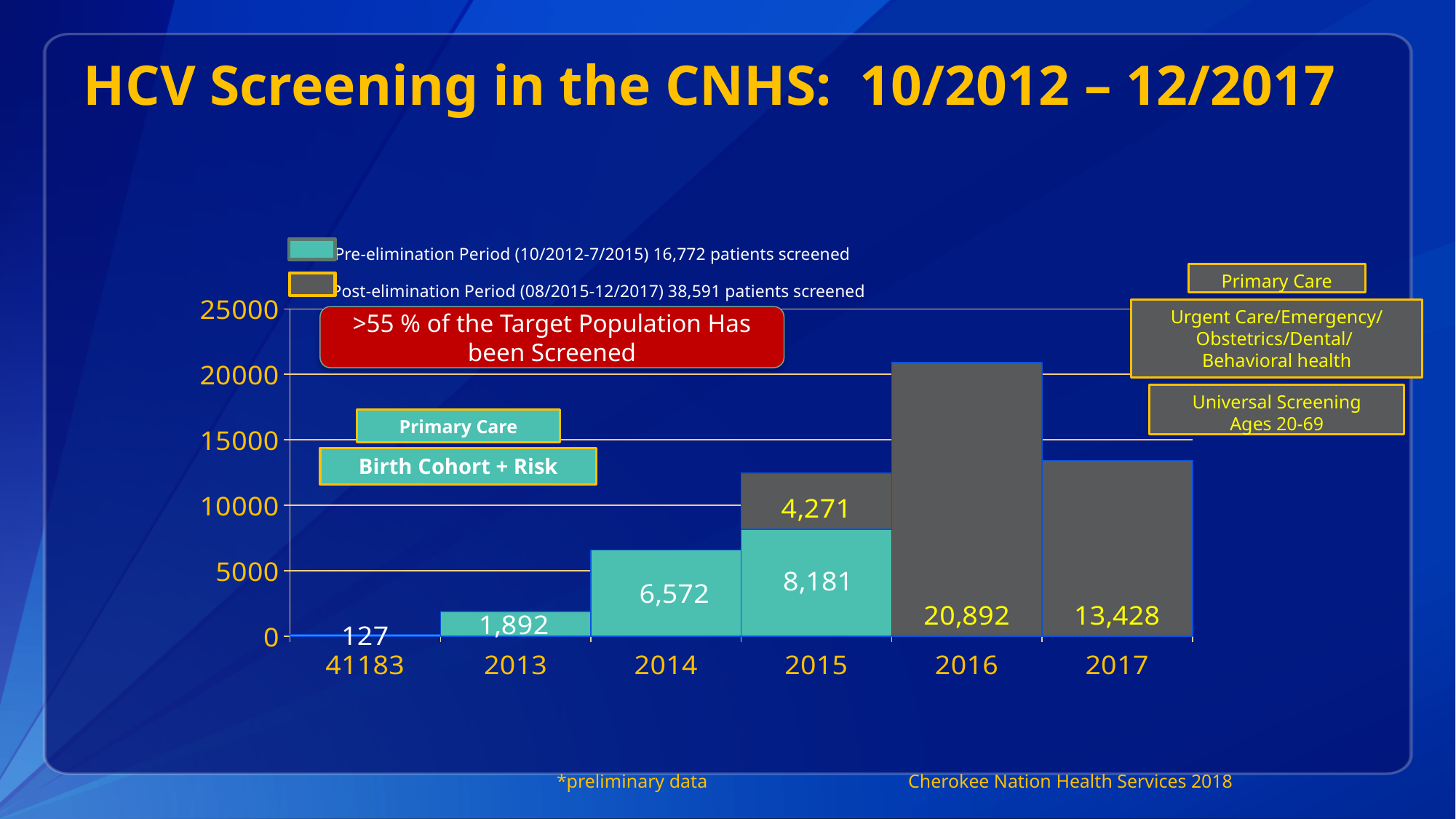
What is the value shown for 2017? 13,428 What kind of chart is shown on the slide? bar chart What is the Pre-elimination Period value for 2014? 6,572 Which year has the highest number of patients screened? 2016 What is the Post-elimination Period value for 2015? 4,271 How many categories are shown on the x axis? 6 What is the value shown for 2016? 20,892 Is the value for 2017 greater or less than 15000? less What is the total of the stacked bar for 2015? 12,452 How many series does the legend list? 2 What is the difference between the values for 2016 and 2017? 7,464 Which is larger, the value for 2014 or the value for 2013? 2014